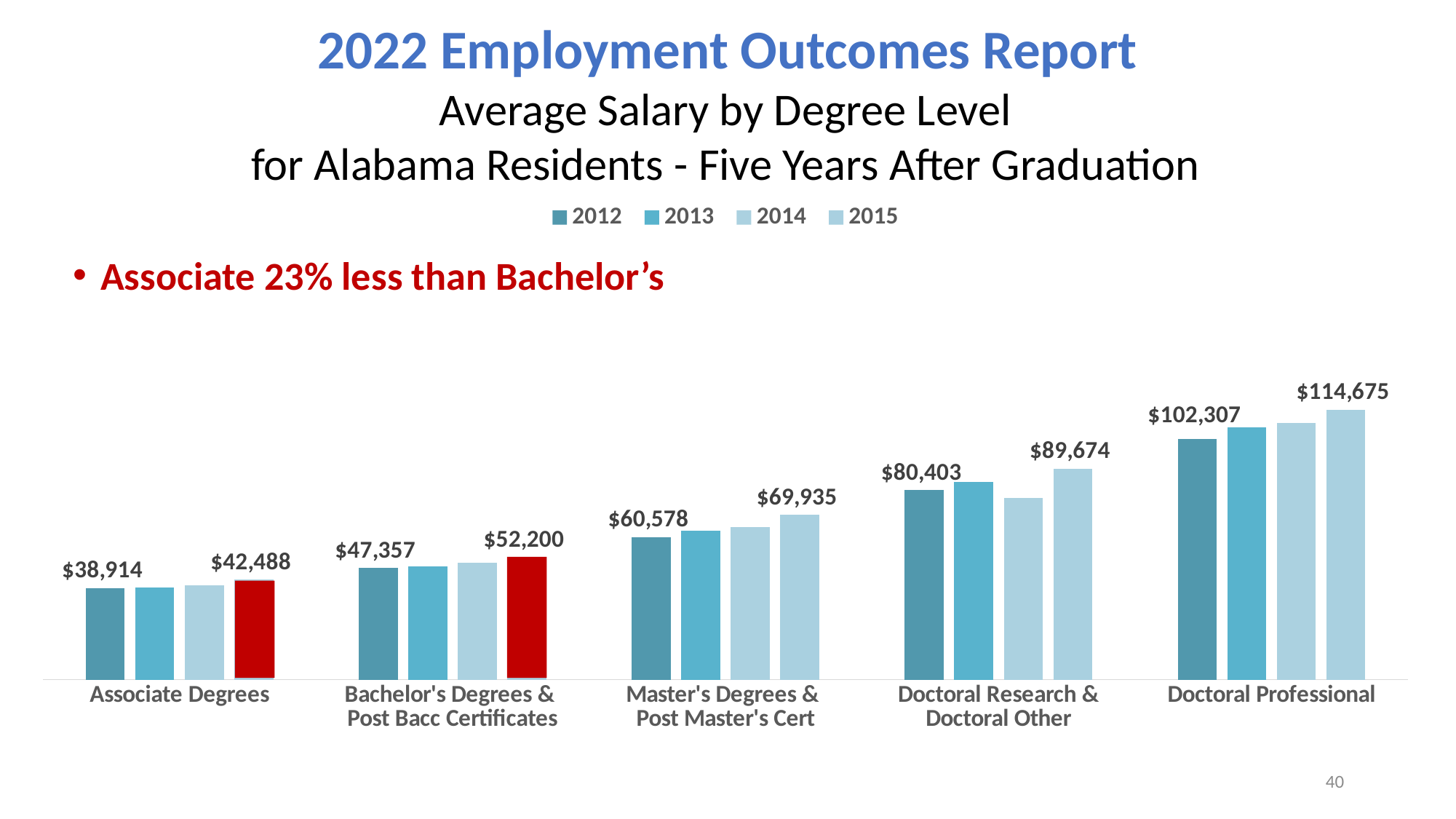
How much higher is the 2015 Doctoral Professional salary than the 2012 Doctoral Professional salary? $12,368 What is the 2012 average salary for Associate Degrees? $38,914 What is the 2015 average salary for Bachelor's Degrees & Post Bacc Certificates? $52,200 What is the 2012 average salary for Doctoral Research & Doctoral Other? $80,403 Which degree level has the highest 2015 average salary? Doctoral Professional How many degree-level categories are shown on the x axis? 5 What is the 2015 average salary for Doctoral Professional degrees? $114,675 Do the 2015 average salaries rise or fall moving from Associate Degrees to Doctoral Professional along the x axis? rise How many series does the legend list? 4 Which degree level has the lowest 2012 average salary? Associate Degrees Which is larger: the 2015 salary for Master's Degrees & Post Master's Cert or the 2012 salary for Doctoral Research & Doctoral Other? 2012 Doctoral Research & Doctoral Other What is the difference between the 2015 Bachelor's Degrees & Post Bacc Certificates salary and the 2015 Associate Degrees salary? $9,712